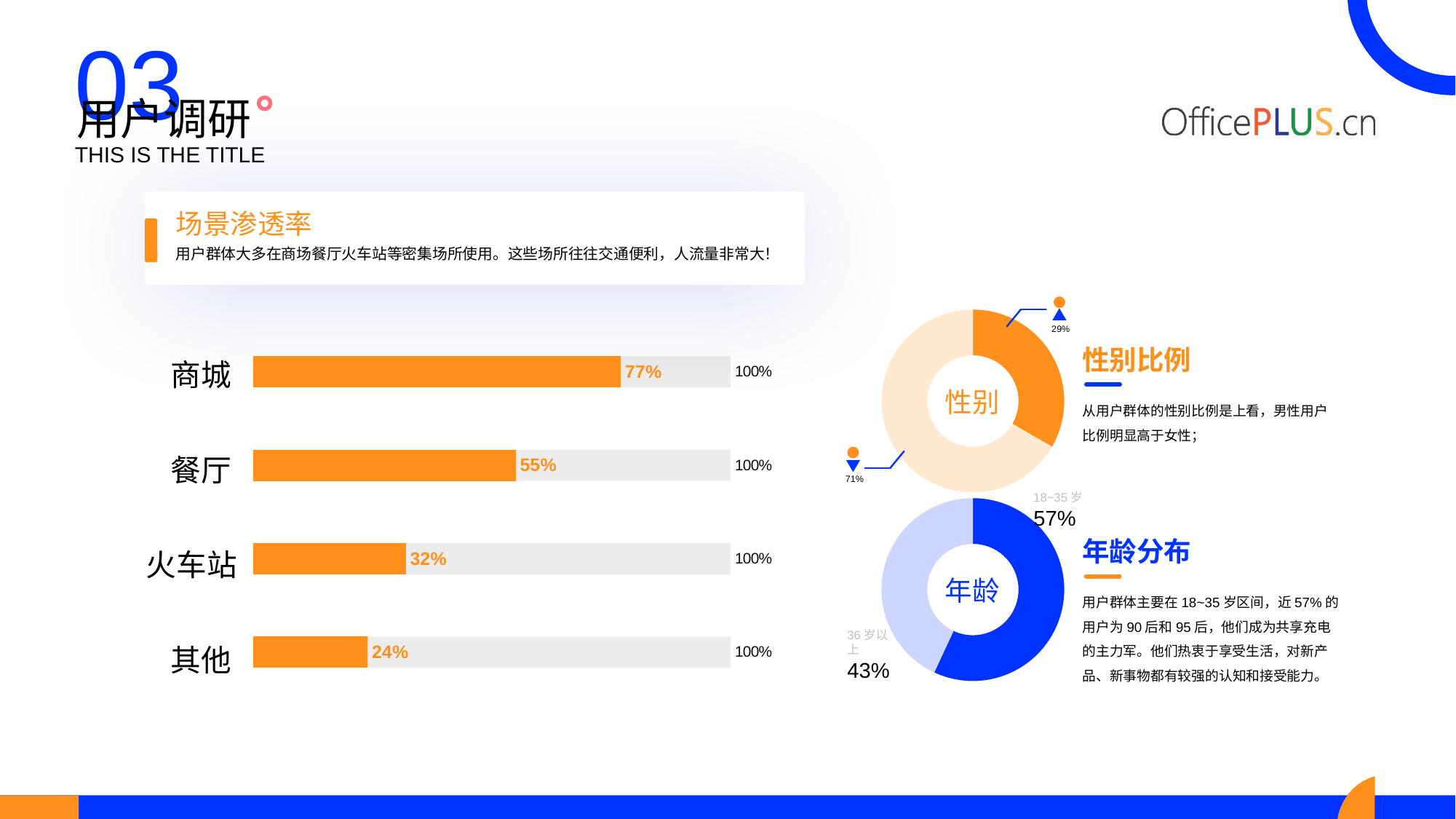
In the 场景渗透率 bar chart, what is the value for 火车站? 32% In the 年龄 donut chart, what is the difference between the 18~35 岁 share and the 36 岁以上 share? 14% In the 年龄 donut chart, what share is shown for 18~35 岁? 57% In the 场景渗透率 bar chart, which category has the lowest value? 其他 In the 场景渗透率 bar chart, what is the difference between the values for 商城 and 餐厅? 22% In the 性别 donut chart, what percentage is shown for the dark orange slice? 29% In the 场景渗透率 bar chart, which is larger, the value for 餐厅 or the value for 其他? 餐厅 In the 场景渗透率 bar chart, which category has the highest value? 商城 What kind of chart is the 场景渗透率 chart on the left of the slide? bar chart How many categories does the 场景渗透率 bar chart show? 4 In the 性别 donut chart, what is the value of the larger slice? 71% In the 场景渗透率 bar chart, what is the value for 商城? 77%